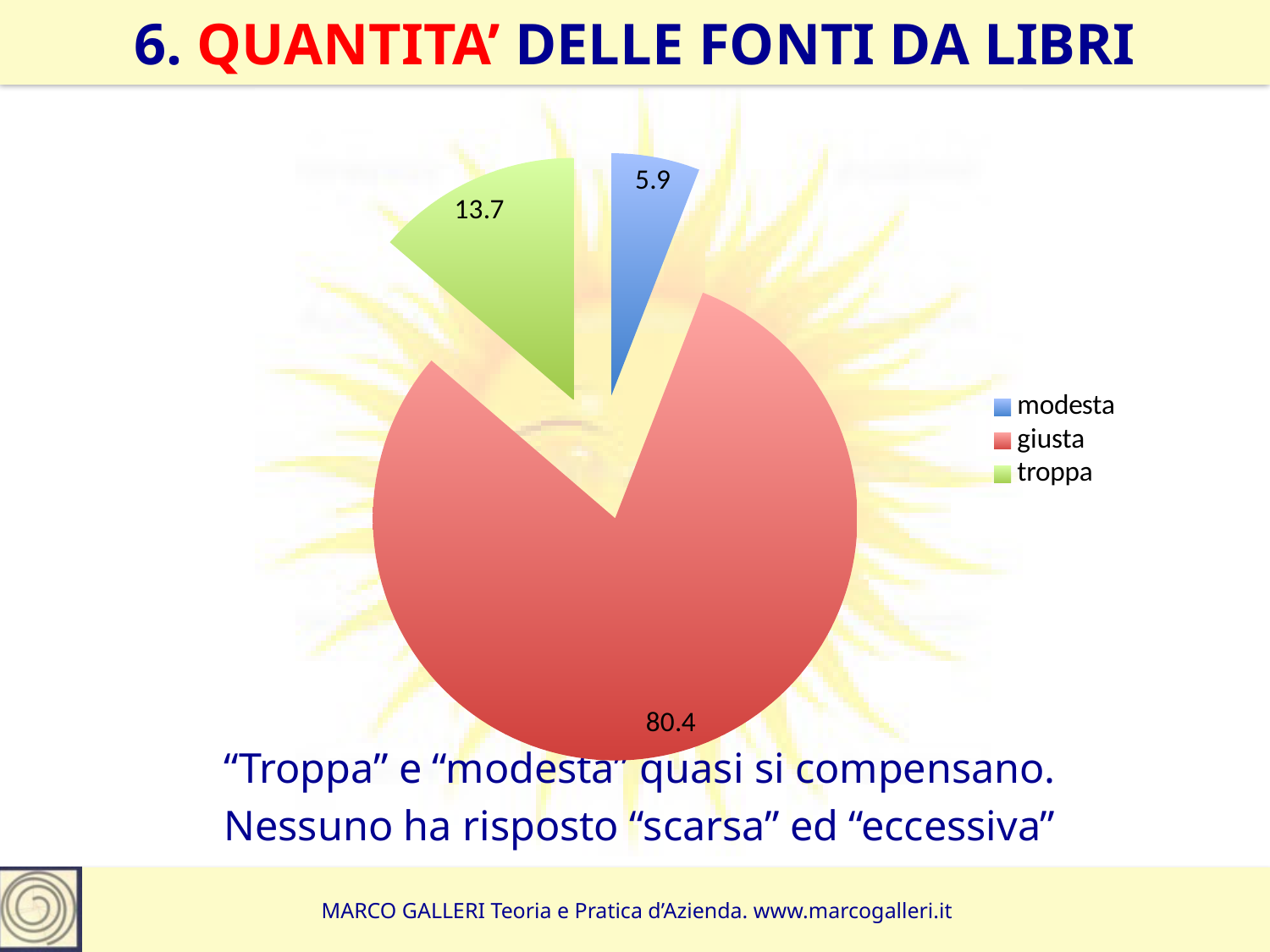
How many slices does the pie chart have? 3 What is the value for "modesta"? 5.9 How many entries does the legend list? 3 What colour is the slice for "troppa"? green What is the difference between the values for "giusta" and "troppa"? 66.7 What is the value for "troppa"? 13.7 What is the value for "giusta"? 80.4 Which category has the smallest slice? modesta Which category has the largest slice? giusta What kind of chart is shown on the slide? pie chart Which is larger, the value for "troppa" or the value for "modesta"? troppa What is the difference between the values for "troppa" and "modesta"? 7.8